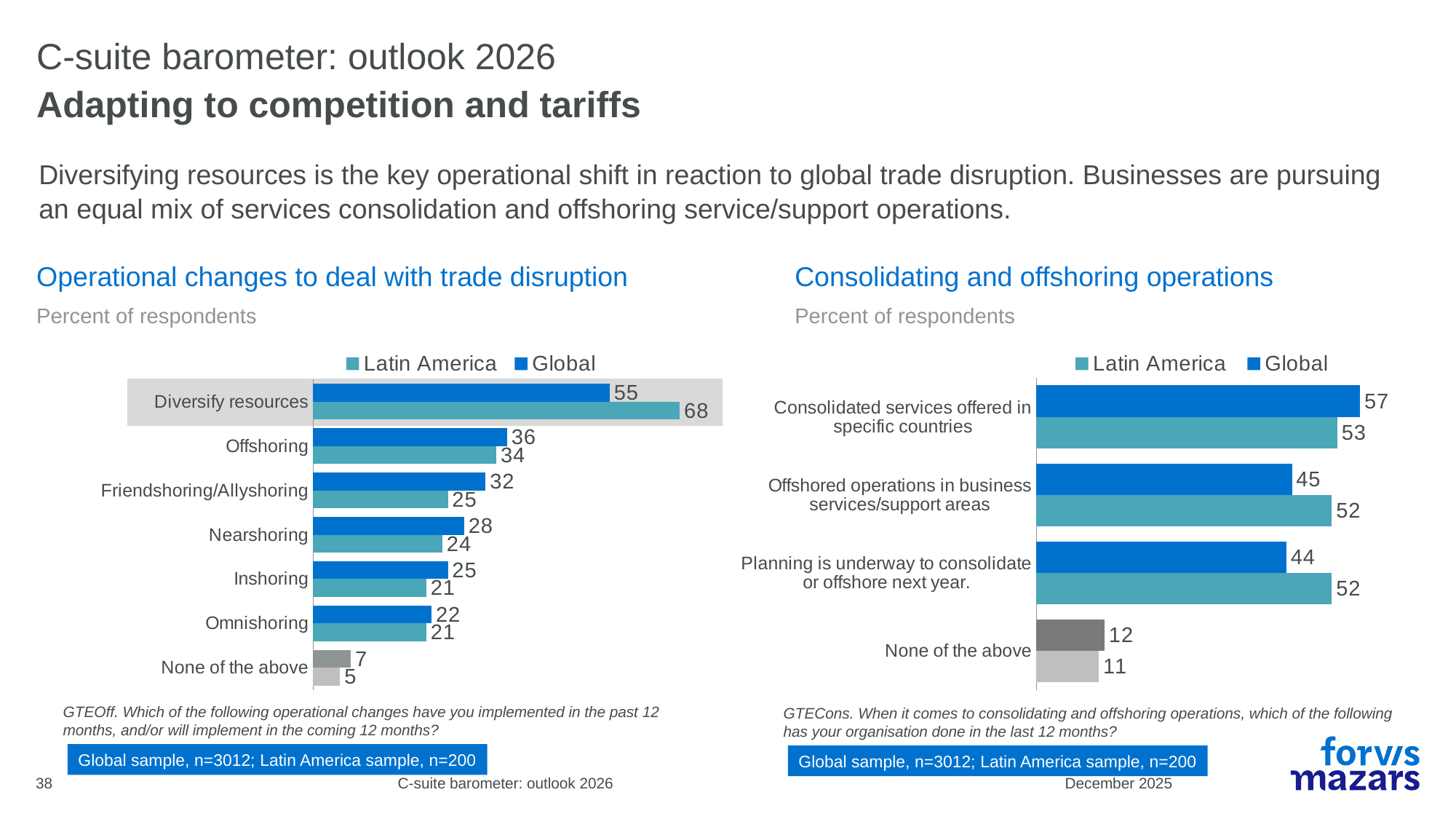
In the 'Operational changes to deal with trade disruption' chart, which category has the lowest Latin America value? None of the above In the 'Consolidating and offshoring operations' chart, what is the difference between the Global and Latin America values for Consolidated services offered in specific countries? 4 In the 'Consolidating and offshoring operations' chart, what is the Latin America value for Offshored operations in business services/support areas? 52 In the 'Operational changes to deal with trade disruption' chart, what is the difference between the Latin America and Global values for Diversify resources? 13 In the 'Consolidating and offshoring operations' chart, which is larger for Planning is underway to consolidate or offshore next year: Latin America or Global? Latin America In the 'Operational changes to deal with trade disruption' chart, which category has the highest Global value? Diversify resources In the 'Consolidating and offshoring operations' chart, what is the Global value for Consolidated services offered in specific countries? 57 In the 'Operational changes to deal with trade disruption' chart, what is the Latin America value for Diversify resources? 68 In the 'Operational changes to deal with trade disruption' chart, what is the Global value for Offshoring? 36 What type of chart is the 'Operational changes to deal with trade disruption' chart? Bar chart In the 'Operational changes to deal with trade disruption' chart, how many categories are shown? 7 How many series does the legend list in the 'Consolidating and offshoring operations' chart? 2